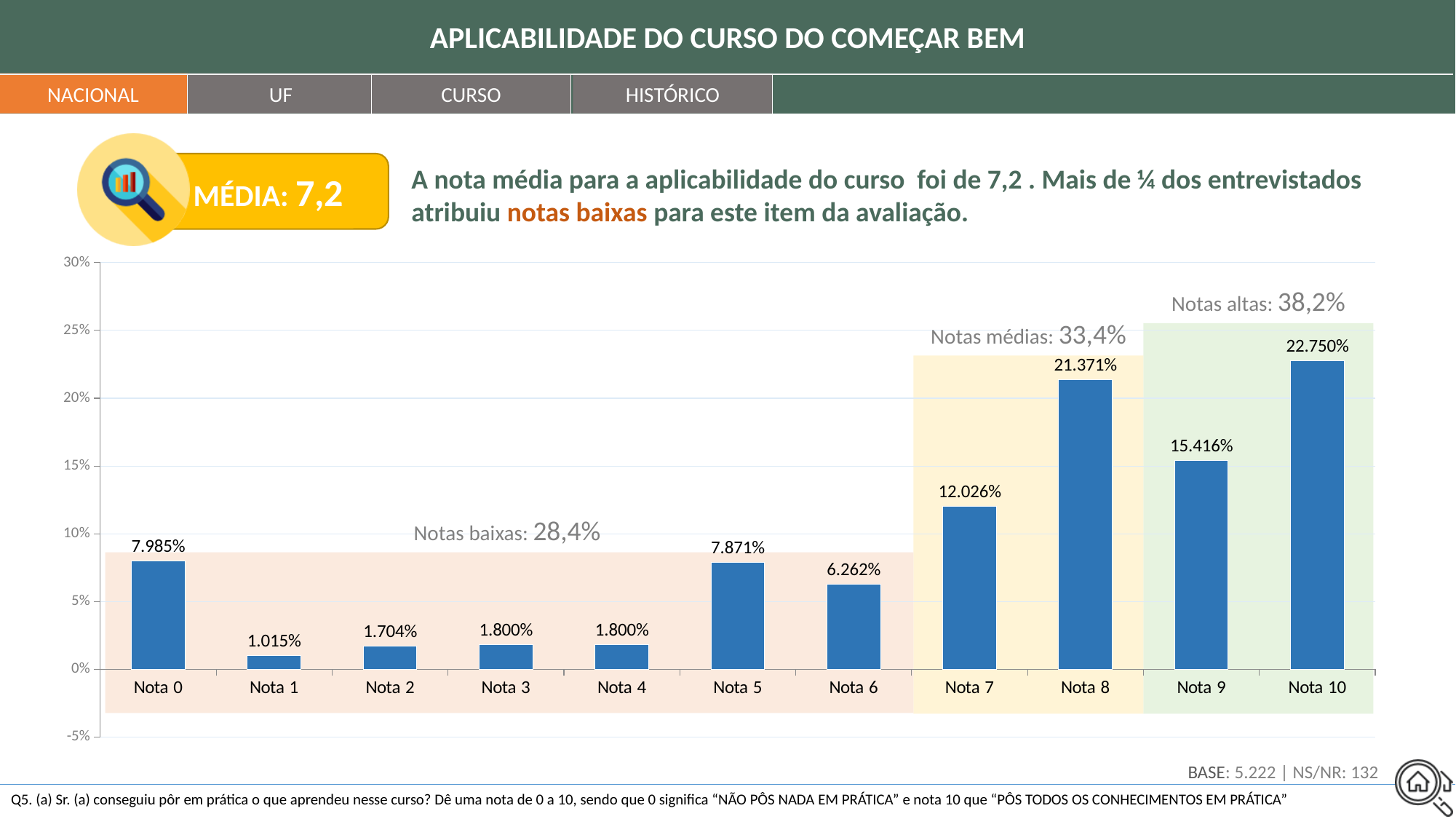
Which category has the highest value? Nota 10 What is the average score (média) shown on the slide? 7,2 What is the value for Nota 10? 22.750% What is the difference between the values for Nota 10 and Nota 8? 1.379% Which category has the lowest value? Nota 1 Which is larger, the value for Nota 0 or the value for Nota 5? Nota 0 What kind of chart is shown on the slide? bar chart What is the value for Nota 7? 12.026% What is the total share labelled for 'Notas altas'? 38,2% Is the value for Nota 9 greater or less than 15%? greater What is the value for Nota 1? 1.015% How many categories are shown on the x axis? 11